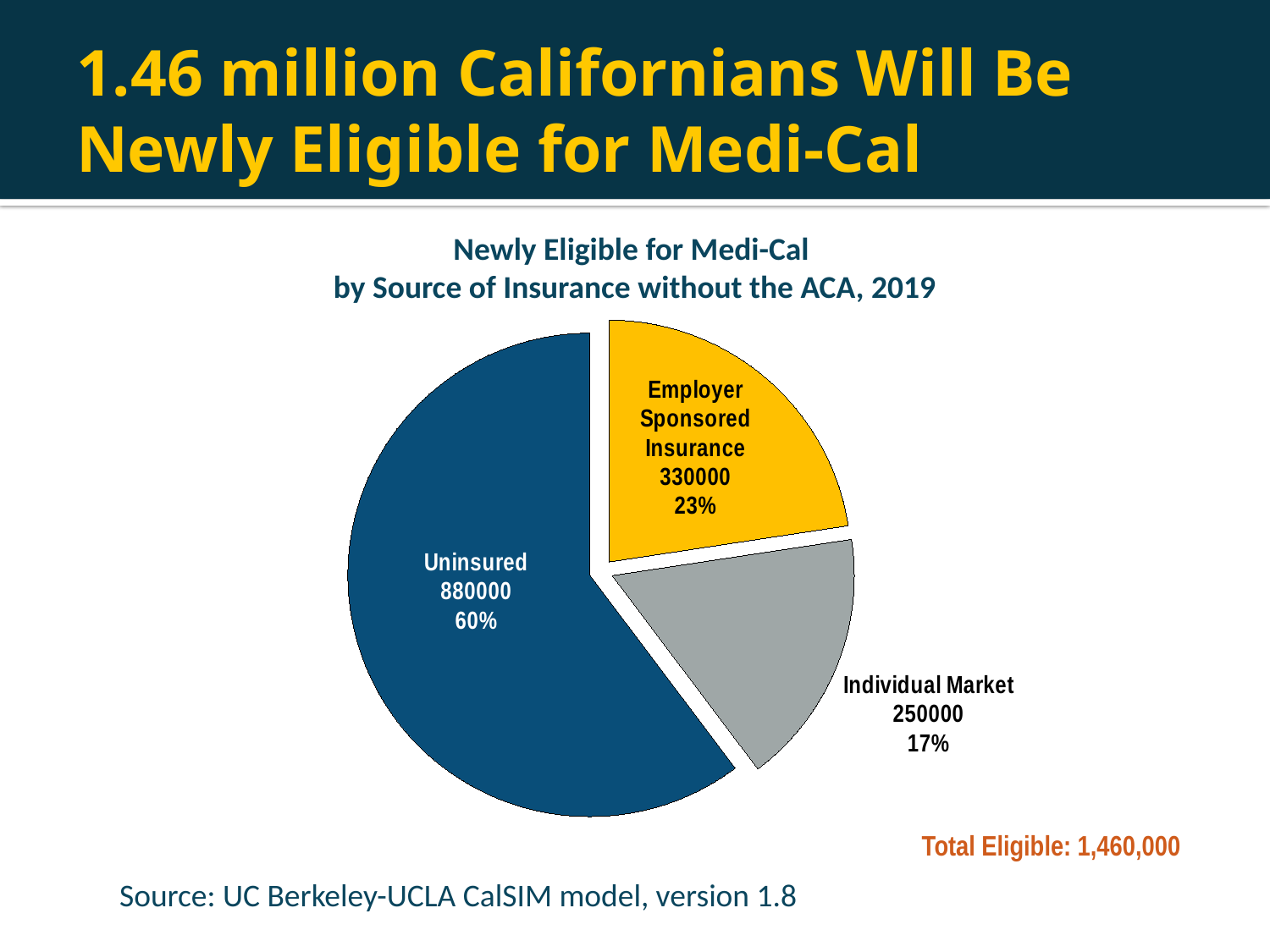
What kind of chart is shown on the slide? pie chart How many slices does the pie chart have? 3 What is the difference between the values for Uninsured and Employer Sponsored Insurance? 550000 Which is larger, Employer Sponsored Insurance or Individual Market? Employer Sponsored Insurance What is the title of the chart? Newly Eligible for Medi-Cal by Source of Insurance without the ACA, 2019 What is the value for Uninsured? 880000 What share of the pie does Individual Market represent? 17% What is the value for Employer Sponsored Insurance? 330000 Which category has the smallest slice? Individual Market What share of the pie does Uninsured represent? 60% What is the value for Individual Market? 250000 Which category has the largest slice? Uninsured